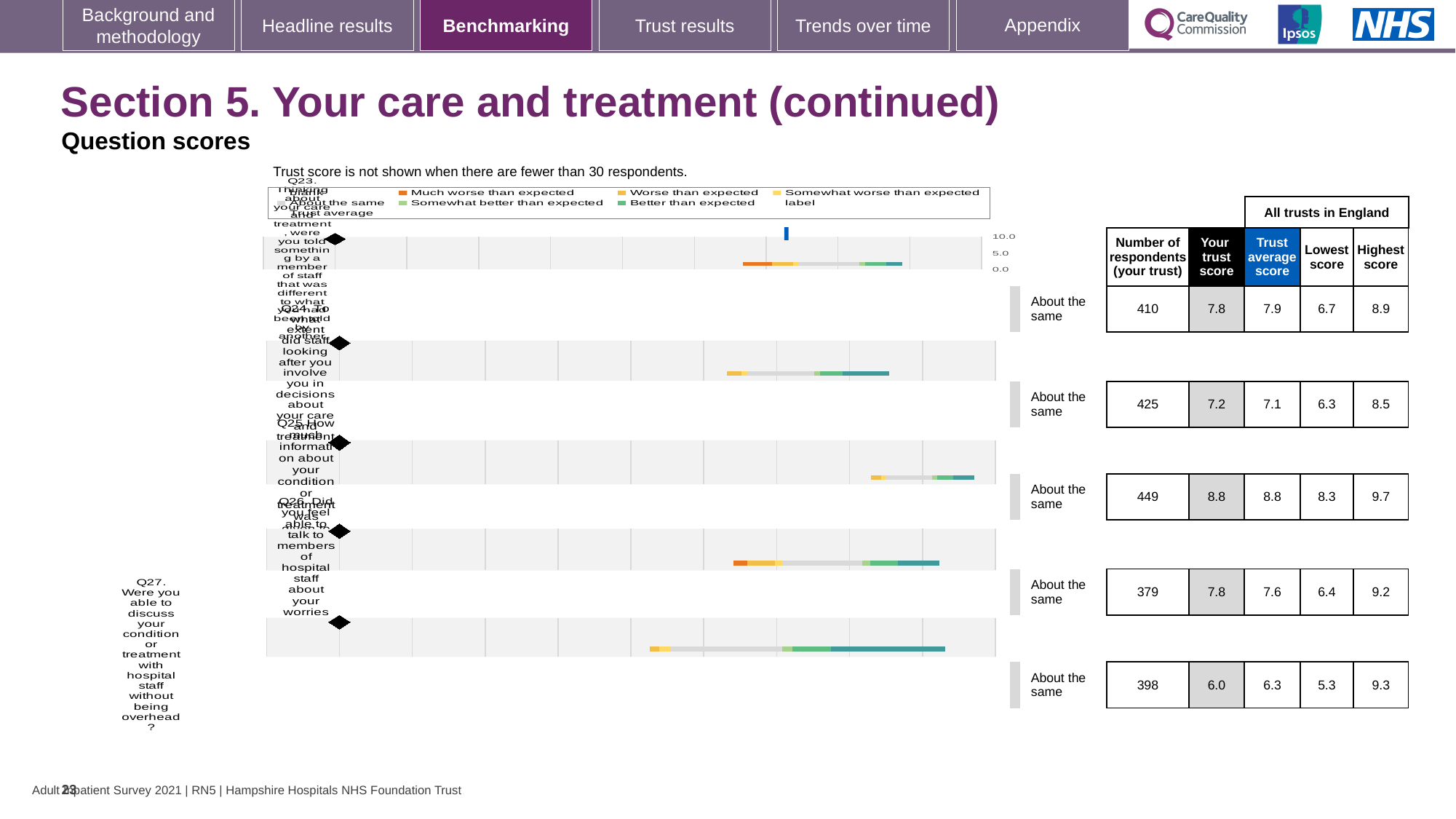
What is the difference between the trust score and the trust average score for Q27? 0.3 Which question has the highest trust score? Q25 What is the highest score among all trusts in England for Q25? 9.7 What benchmark category is shown next to every question in the chart? About the same How many questions (Q23 to Q27) are plotted in the chart? 5 What is the trust average score for Q26? 7.6 How many respondents from the trust answered Q24? 425 What kind of chart is used to show the question scores on this slide? bar chart Is the trust score for Q24 larger or smaller than the trust average score for Q24? larger What is the trust score for Q25 (how much information about your condition or treatment was given)? 8.8 What is the trust score for Q27 (able to discuss your condition or treatment without being overheard)? 6.0 Which question has the lowest trust score? Q27